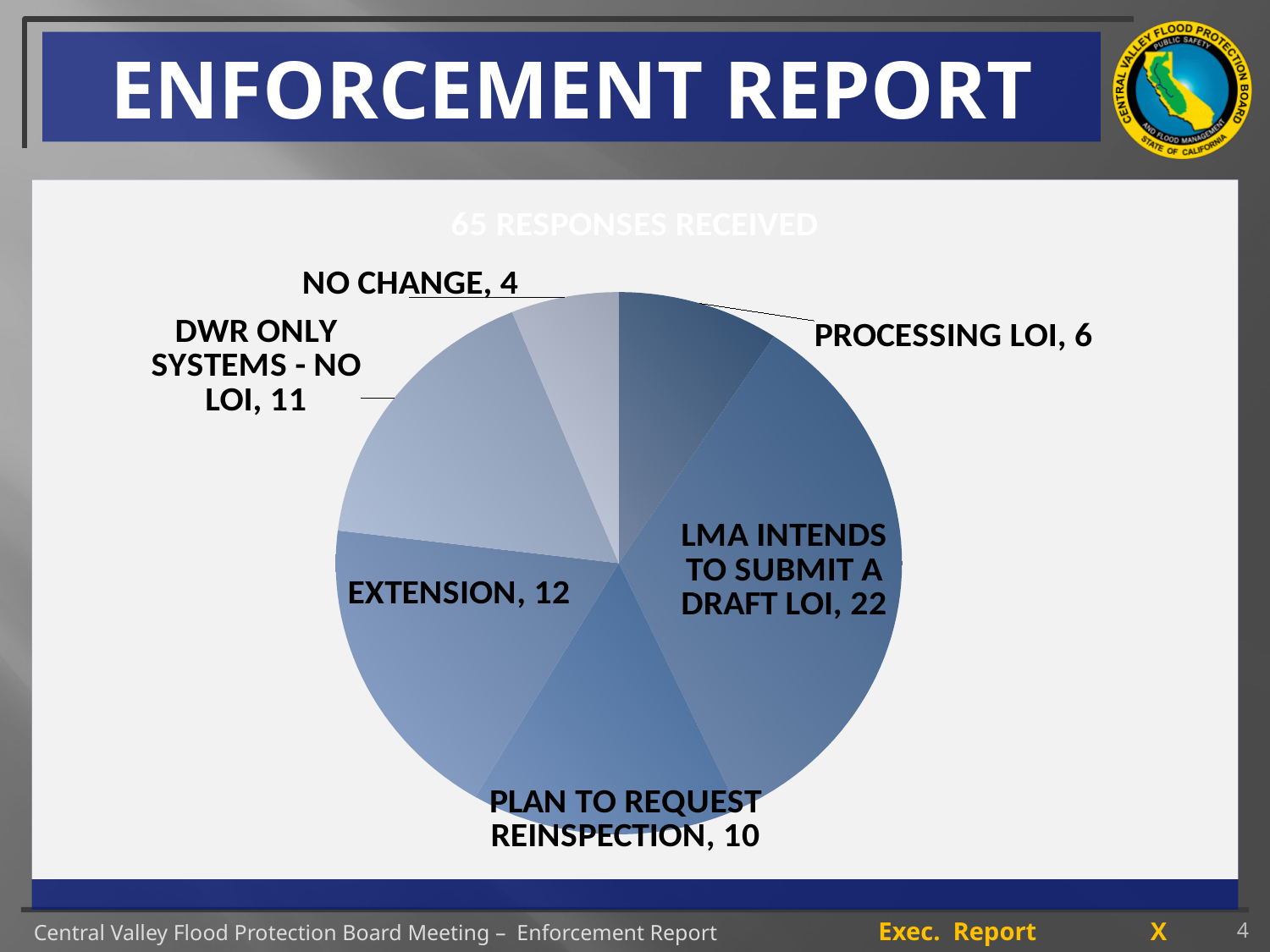
What type of chart is shown on the slide? Pie chart What is the value for 'DWR Only Systems - No LOI'? 11 What is the title of the pie chart? 65 RESPONSES RECEIVED How many categories are shown in the pie chart? 6 Which is larger, 'Processing LOI' or 'Plan to Request Reinspection'? Plan to Request Reinspection Which category has the smallest slice of the pie? No Change What is the total of all the slices in the pie chart? 65 What is the difference between the 'LMA Intends to Submit a Draft LOI' value and the 'Extension' value? 10 How many responses are in the 'LMA Intends to Submit a Draft LOI' slice? 22 What is the value for 'Plan to Request Reinspection'? 10 Which category has the largest slice of the pie? LMA Intends to Submit a Draft LOI What is the value for 'Extension'? 12